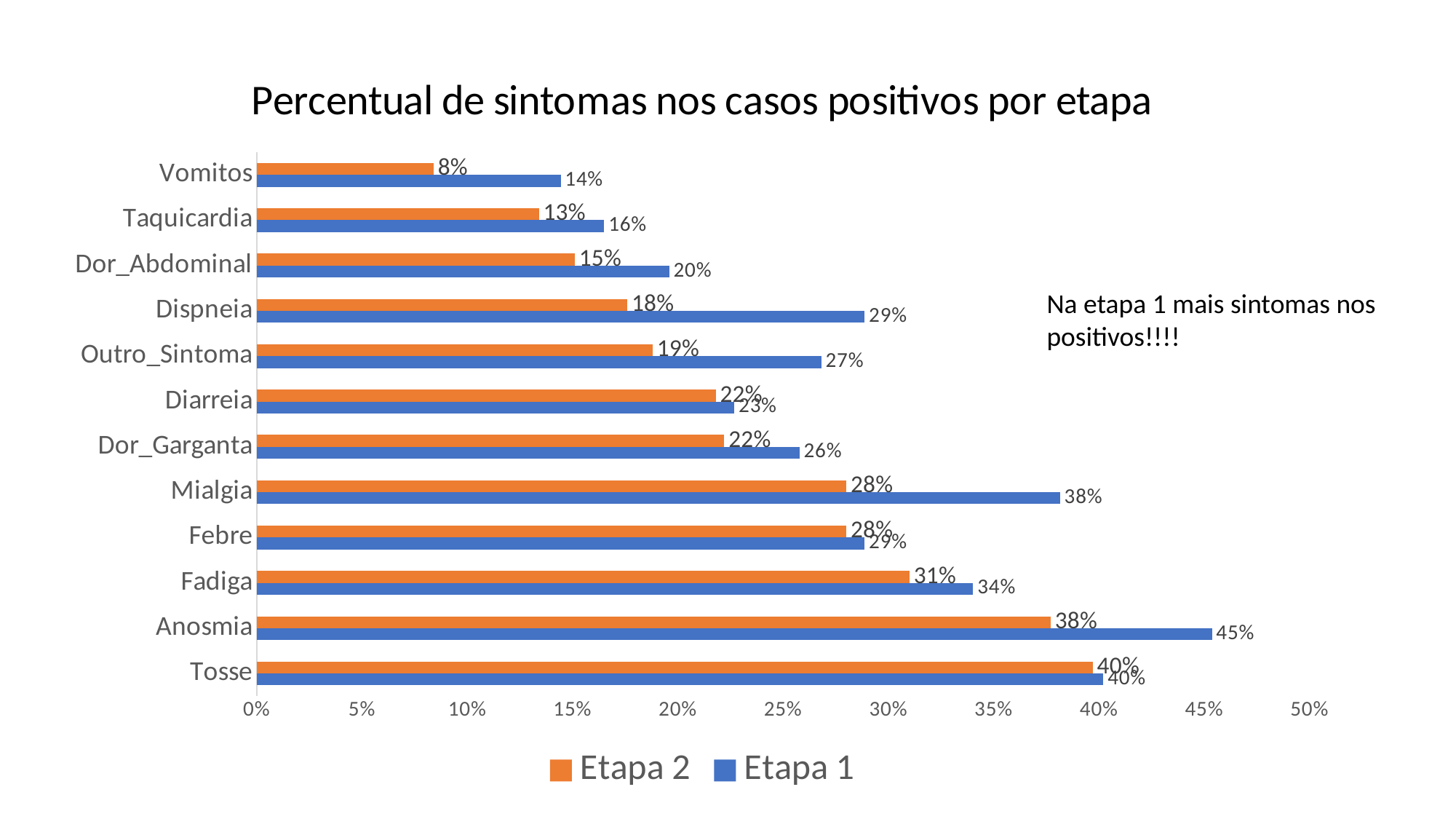
Which symptom has the highest Etapa 1 value? Anosmia What kind of chart is shown on the slide? Bar chart What is the Etapa 2 value for Dispneia? 18% What is the Etapa 2 value for Vomitos? 8% What is the title of the chart? Percentual de sintomas nos casos positivos por etapa What is the Etapa 1 value for Mialgia? 38% How many symptom categories are shown on the chart? 12 What is the difference between the Etapa 1 and Etapa 2 values for Dispneia? 11% What is the Etapa 1 value for Anosmia? 45% Which is larger for Mialgia, the Etapa 1 value or the Etapa 2 value? Etapa 1 How many series does the legend list? 2 Which symptom has the lowest Etapa 2 value? Vomitos